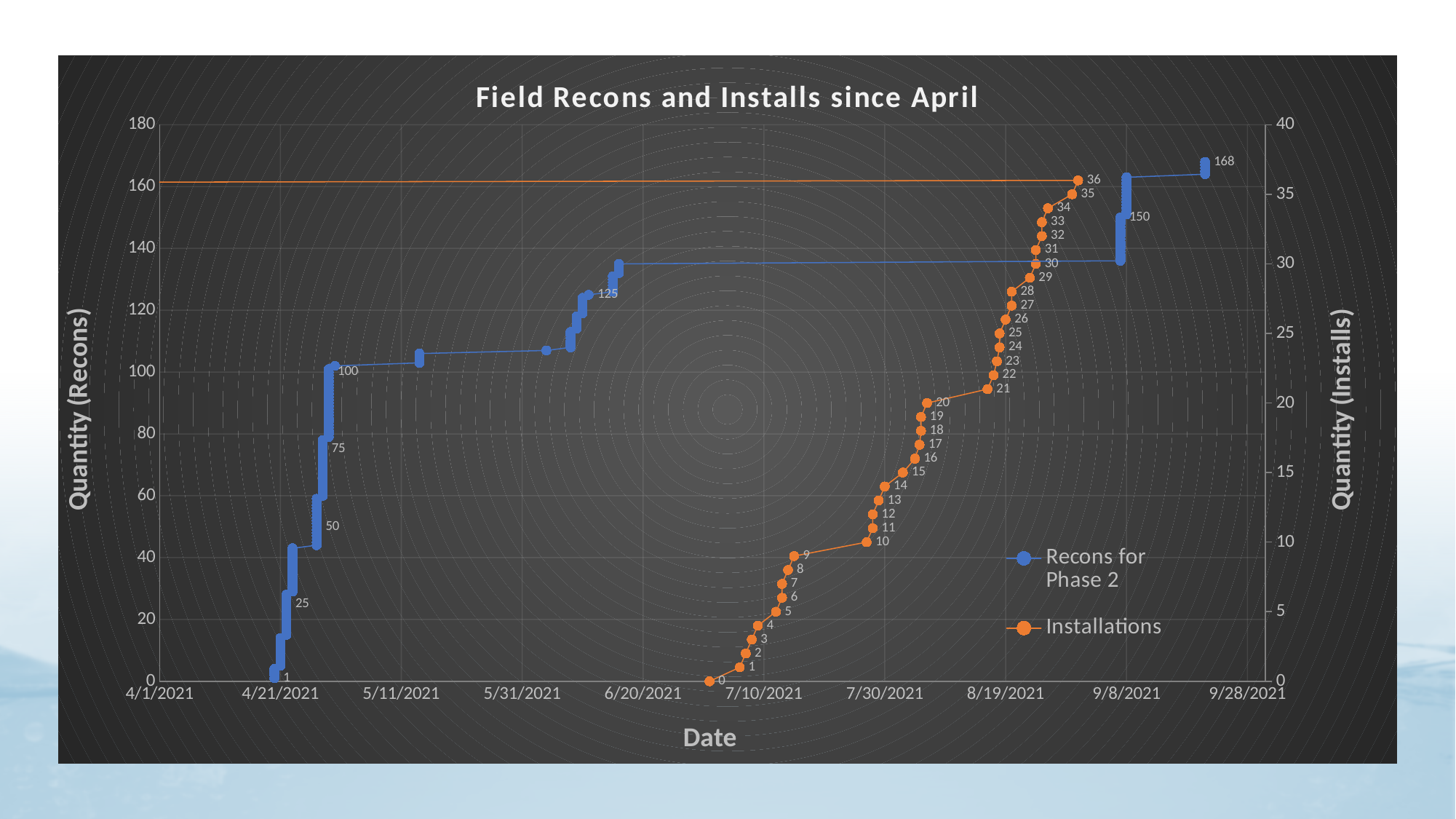
Is the Installations value at 7/30/2021 greater or less than 15? less What are the two series named in the legend? Recons for Phase 2 and Installations Do the Recons for Phase 2 values rise or fall over time along the x axis? rise Is the Recons for Phase 2 value at 6/20/2021 greater or less than 120? greater What is the highest labeled value of the Recons for Phase 2 series? 168 What is the lowest labeled value of the Installations series? 0 What is the title of the chart? Field Recons and Installs since April What is the highest labeled value of the Installations series? 36 Which series reaches a higher labeled final value, Recons for Phase 2 (168) or Installations (36)? Recons for Phase 2 What is the difference between the last two labeled Recons for Phase 2 values, 168 and 150? 18 What kind of chart is shown on the slide? line chart How many series does the legend list? 2